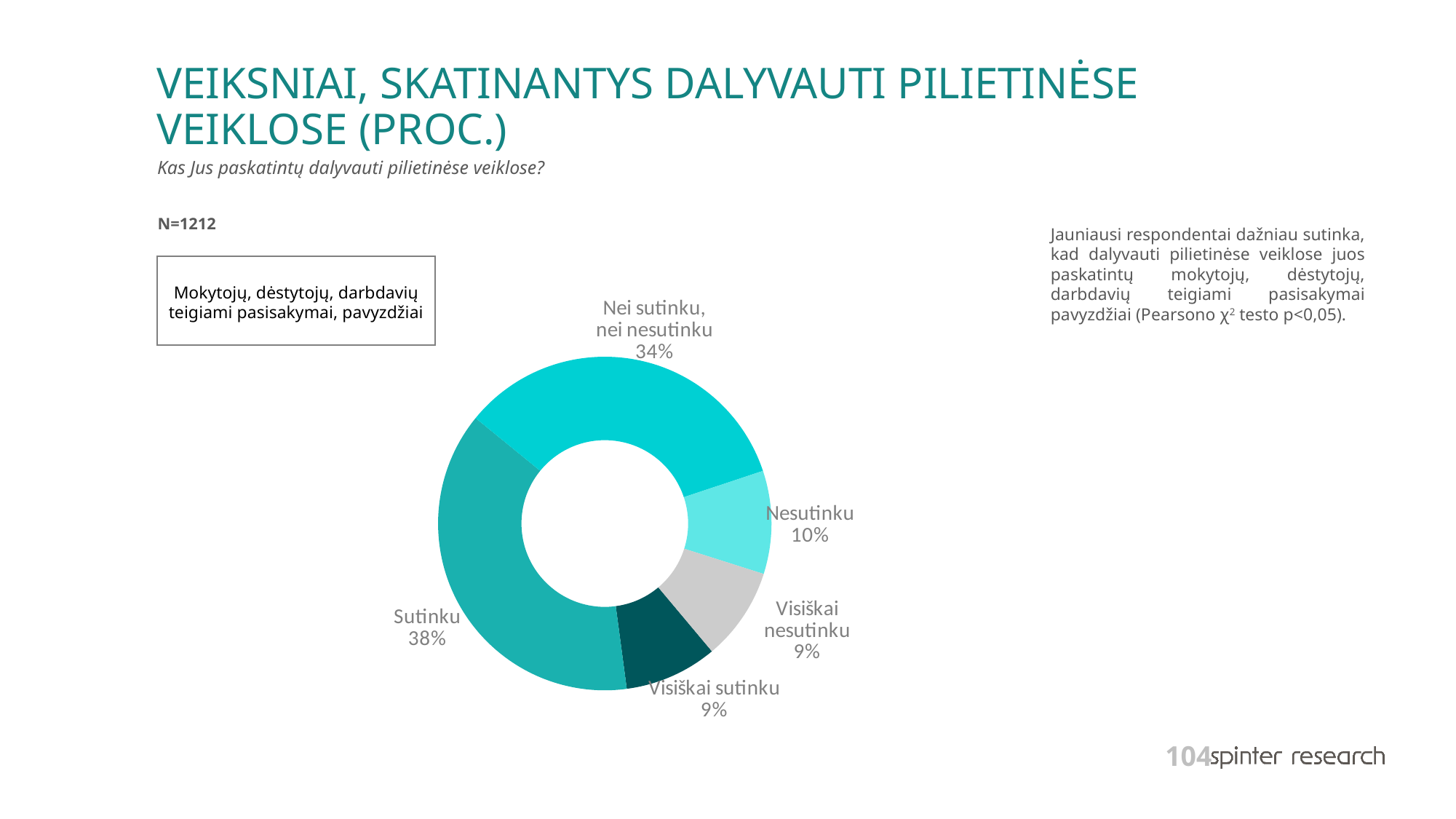
What is the sample size (N) stated on the slide? N=1212 What percentage of respondents answered "Visiškai nesutinku"? 9% What is the combined share of "Sutinku" and "Visiškai sutinku"? 47% Which response category has the largest share of the chart? Sutinku What percentage of respondents answered "Sutinku"? 38% What percentage of respondents answered "Nei sutinku, nei nesutinku"? 34% Which is larger: the share for "Nesutinku" or the share for "Visiškai nesutinku"? Nesutinku How many response categories are shown in the chart? 5 What percentage of respondents answered "Nesutinku"? 10% What kind of chart is shown on the slide? Doughnut chart What percentage of respondents answered "Visiškai sutinku"? 9% What is the difference in percentage points between "Sutinku" and "Nei sutinku, nei nesutinku"? 4